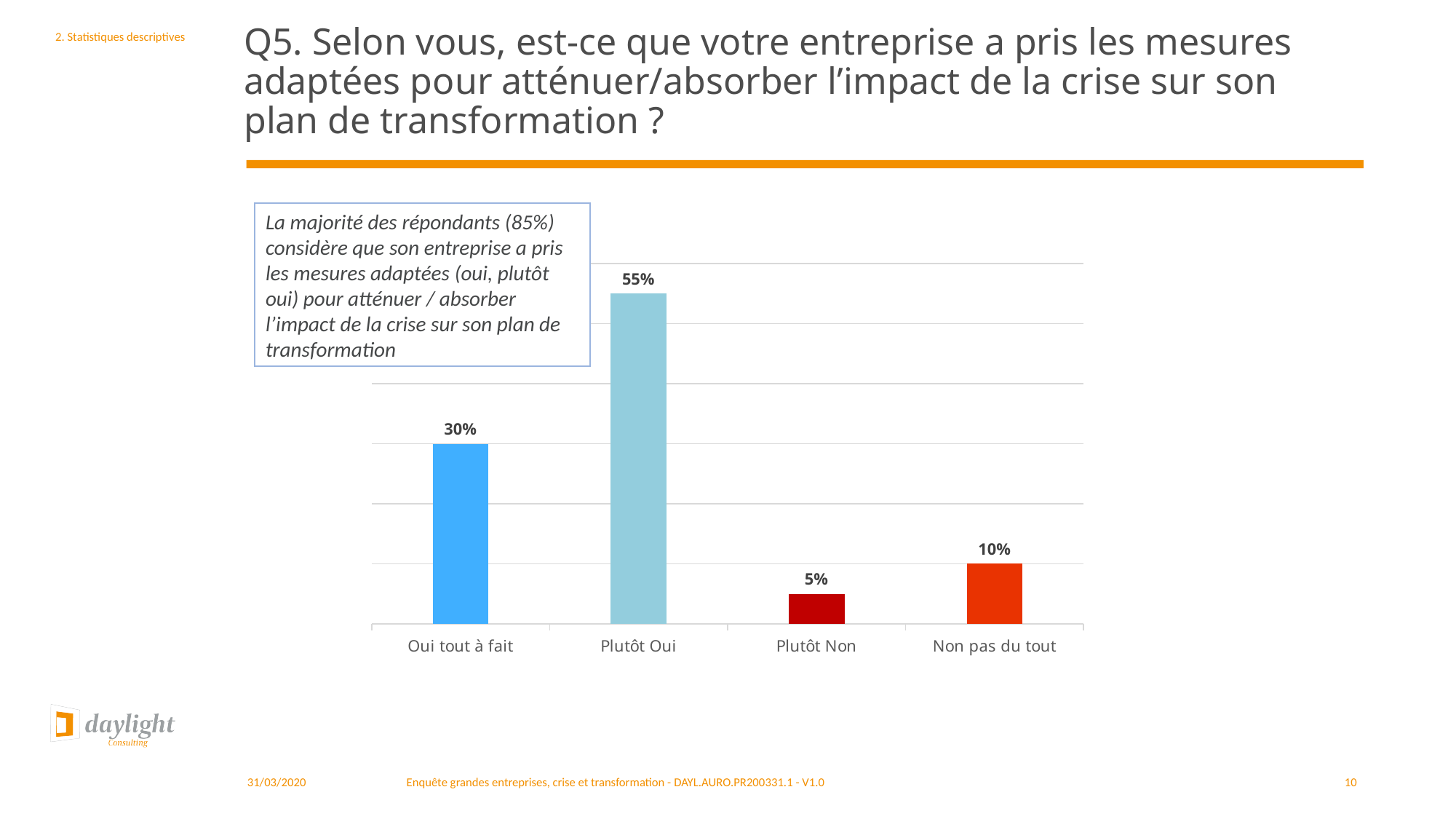
What is the value for "Plutôt Non"? 5% What is the difference between the values for "Plutôt Oui" and "Oui tout à fait"? 25% Which category has the lowest value? Plutôt Non How many categories are shown on the x axis? 4 What is the value for "Plutôt Oui"? 55% Which is larger, the value for "Oui tout à fait" or the value for "Non pas du tout"? Oui tout à fait What is the value for "Non pas du tout"? 10% Which category has the highest value? Plutôt Oui What kind of chart is shown on the slide? Bar chart What is the difference between the values for "Non pas du tout" and "Plutôt Non"? 5% What colour is the bar for "Plutôt Non"? Dark red What is the value for "Oui tout à fait"? 30%